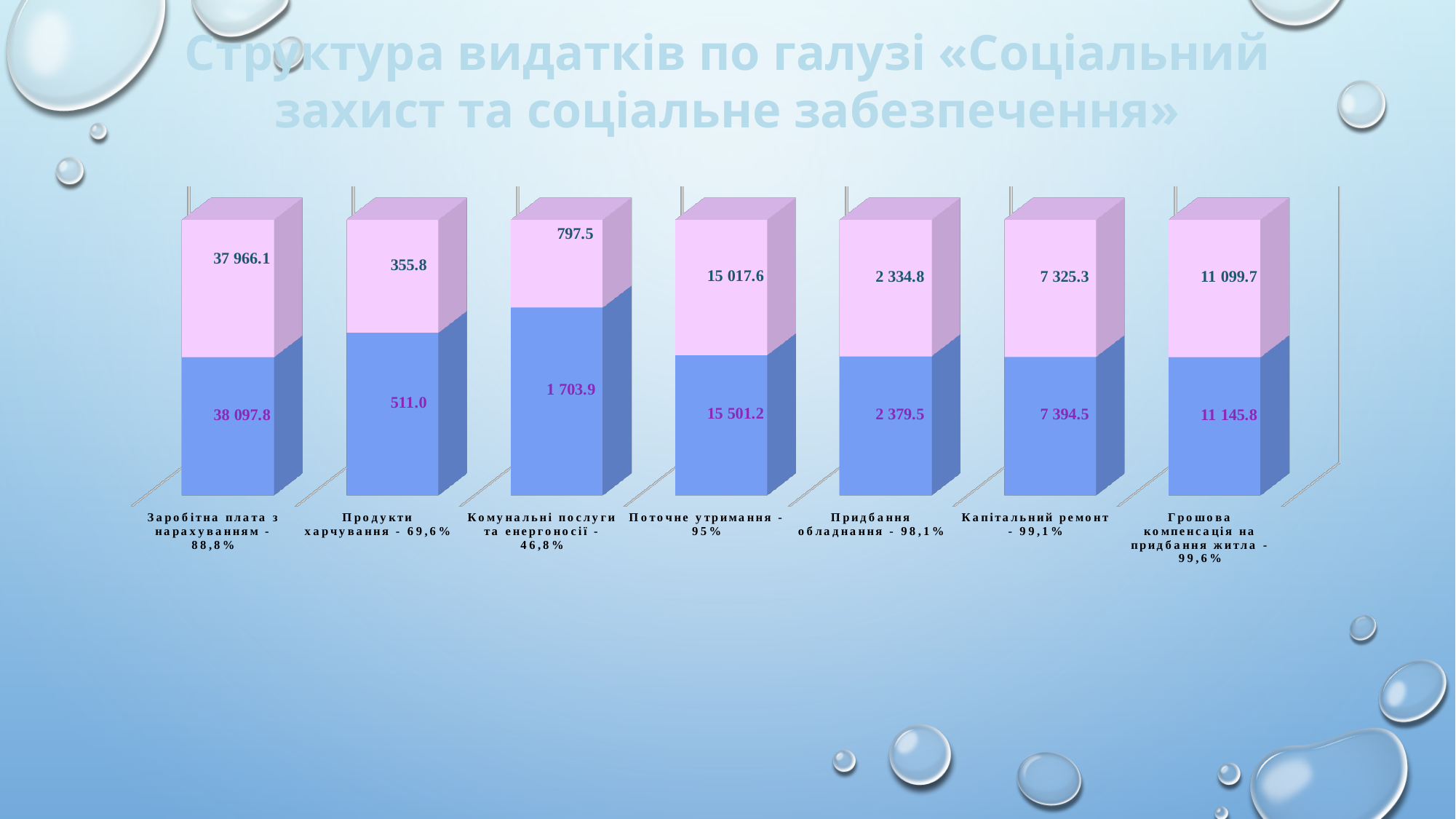
What kind of chart is shown on the slide? stacked bar chart What is the value of the blue segment for «Грошова компенсація на придбання житла - 99,6%»? 11 145.8 What is the value of the pink segment for «Комунальні послуги та енергоносії - 46,8%»? 797.5 Which category has the highest blue segment value? Заробітна плата з нарахуванням - 88,8% What is the value of the blue segment for «Заробітна плата з нарахуванням - 88,8%»? 38 097.8 What is the difference between the blue and pink segment values for «Продукти харчування - 69,6%»? 155.2 What is the difference between the blue and pink segment values for «Комунальні послуги та енергоносії - 46,8%»? 906.4 Which is larger for «Поточне утримання - 95%»: the blue segment or the pink segment? the blue segment How many categories are shown in the chart? 7 What is the sum of the two segment values for «Капітальний ремонт - 99,1%»? 14 719.8 Which category has the lowest pink segment value? Продукти харчування - 69,6% What is the value of the pink segment for «Придбання обладнання - 98,1%»? 2 334.8